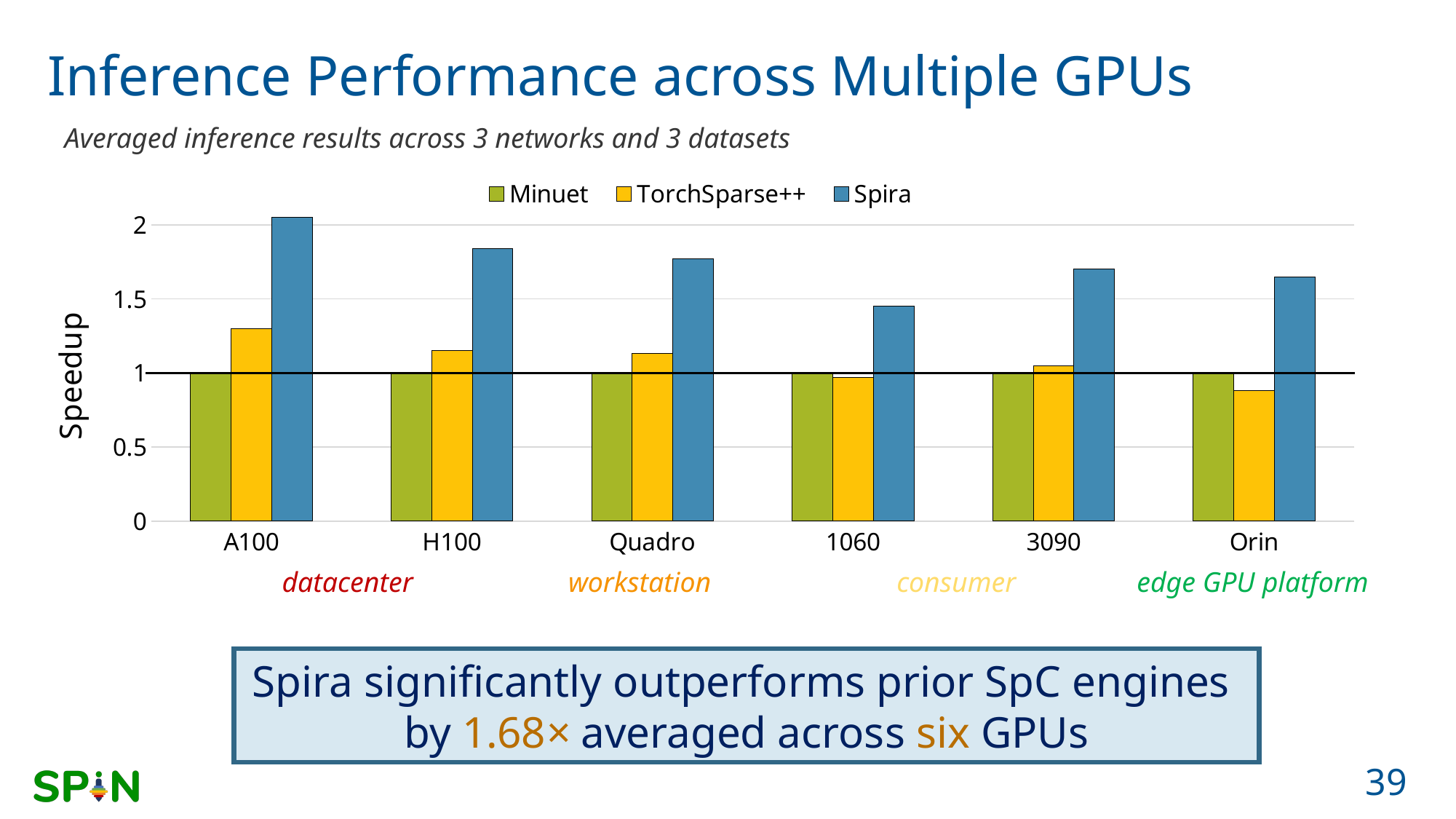
For which GPU is the Spira speedup highest? A100 How many series does the legend list? 3 Is the TorchSparse++ speedup for Orin greater or less than 1? less How many GPU categories are shown on the x axis? 6 Is the Spira speedup for A100 greater or less than 2? greater What kind of chart is shown on the slide? bar chart Is the Spira speedup for 1060 greater or less than 1.5? less For which GPU is the Spira speedup lowest? 1060 What is the Minuet speedup for A100? 1 What is the label of the y axis? Speedup Which has the larger speedup on H100, Spira or TorchSparse++? Spira